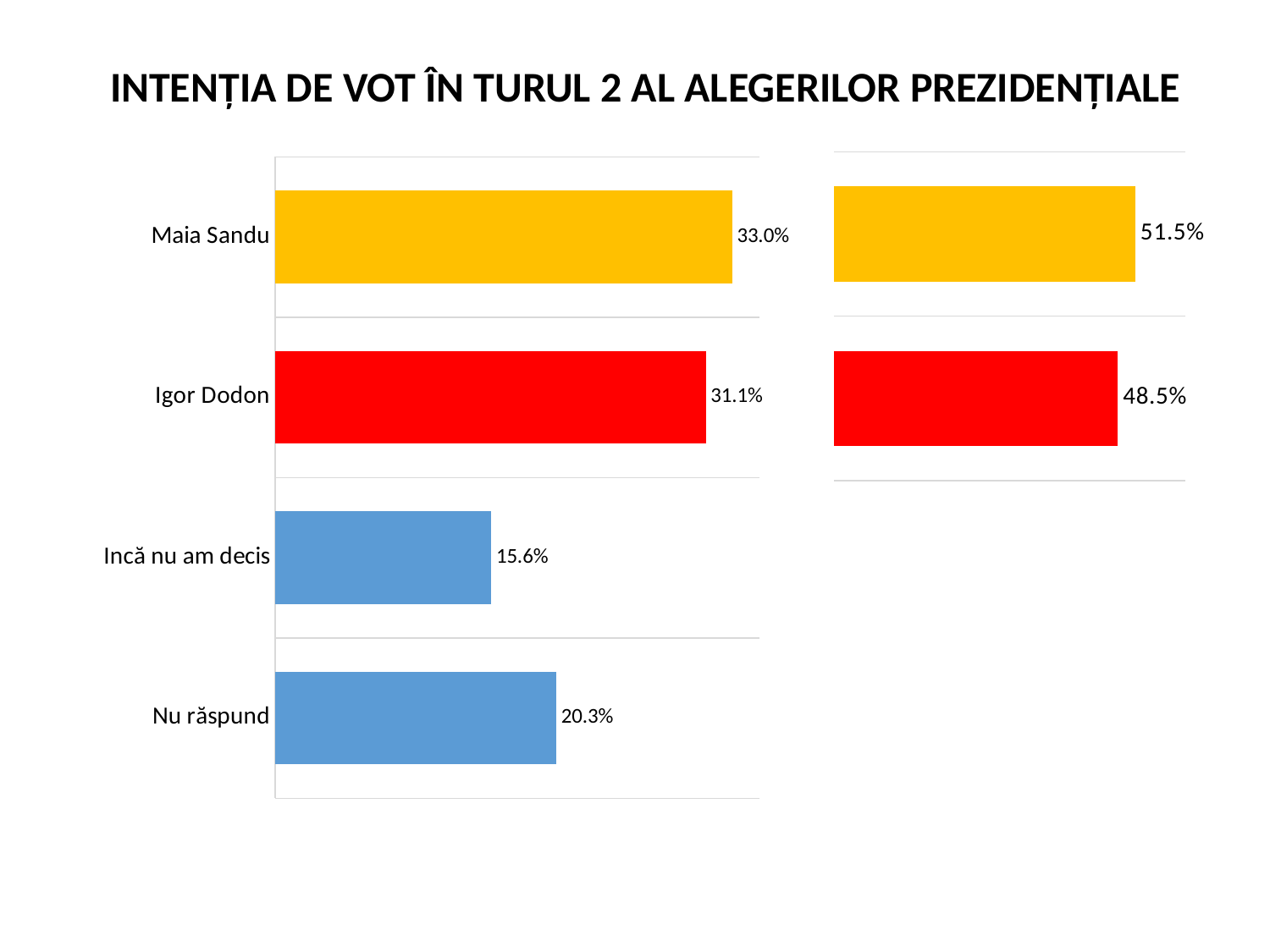
In the right chart, what is the value of the top (yellow) bar, in the row of Maia Sandu? 51.5% In the left chart, which is larger: the value for Nu răspund or the value for Incă nu am decis? Nu răspund In the left chart, what is the value for Igor Dodon? 31.1% In the left chart, which category has the lowest value? Incă nu am decis How many categories does the left chart show? 4 In the left chart, what is the value for Maia Sandu? 33.0% In the left chart, what is the value for Nu răspund? 20.3% What type of chart is shown on the slide? Bar chart In the left chart, what is the value for Incă nu am decis? 15.6% In the left chart, which category has the highest value? Maia Sandu In the right chart, what is the value of the red bar, in the row of Igor Dodon? 48.5% In the left chart, what is the difference between the values for Maia Sandu and Igor Dodon? 1.9%